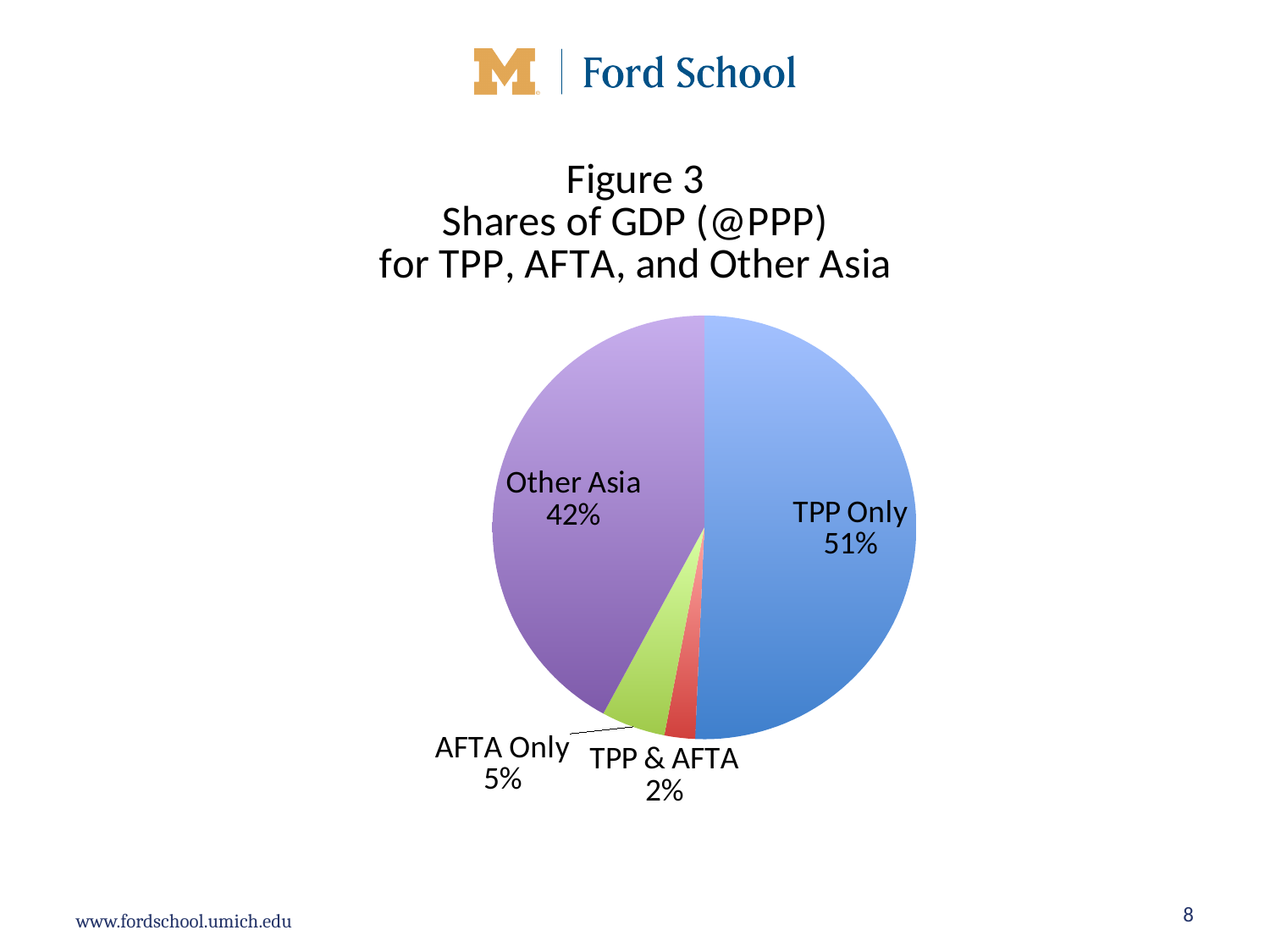
Which slice of the pie is the smallest? TPP & AFTA What is the title of the chart? Figure 3 Shares of GDP (@PPP) for TPP, AFTA, and Other Asia Which slice of the pie is the largest? TPP Only What is the combined share of AFTA Only and TPP & AFTA? 7% What kind of chart is shown on the slide? Pie chart What is the difference in percentage points between the TPP Only share and the Other Asia share? 9 percentage points Which is larger, the AFTA Only share or the TPP & AFTA share? AFTA Only How many slices does the pie chart have? 4 What share of GDP does TPP & AFTA account for? 2% What share of GDP does TPP Only account for? 51% What share of GDP does Other Asia account for? 42% What share of GDP does AFTA Only account for? 5%